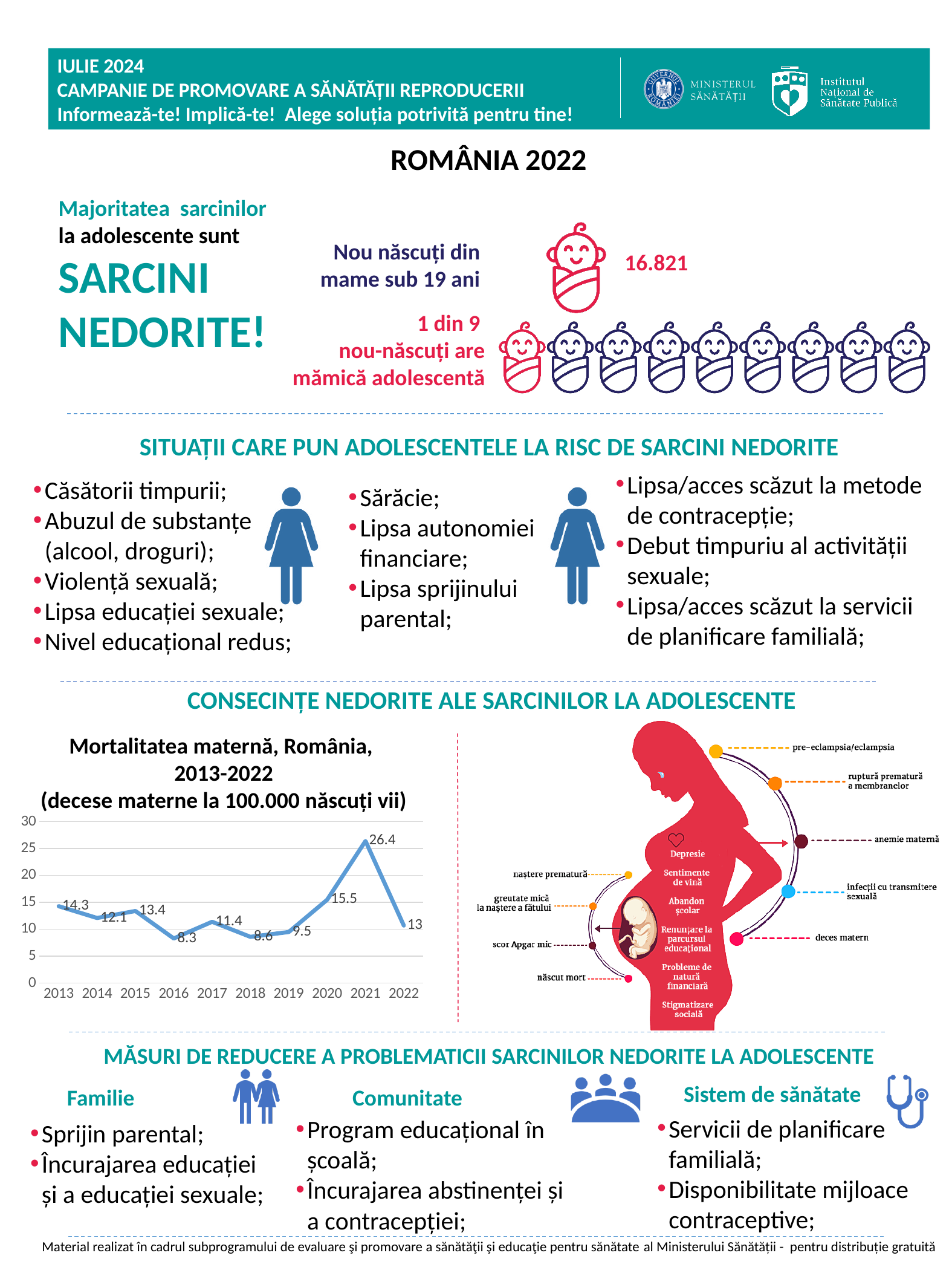
What is the maternal mortality value for 2013 in the chart? 14.3 Which year has the highest maternal mortality value in the chart? 2021 Which year has the lowest maternal mortality value in the chart? 2016 Which year has a higher maternal mortality value, 2015 or 2019? 2015 Does the maternal mortality value rise or fall from 2021 to 2022? fall What type of chart is used to show maternal mortality in Romania, 2013-2022? line chart What is the maternal mortality value for 2022 in the chart? 13 What is the maternal mortality value for 2016 in the chart? 8.3 What is the title of the line chart on the slide? Mortalitatea maternă, România, 2013-2022 (decese materne la 100.000 născuți vii) What is the difference between the maternal mortality values for 2021 and 2020? 10.9 What is the maternal mortality value for 2021 in the chart? 26.4 How many years are plotted in the maternal mortality chart? 10